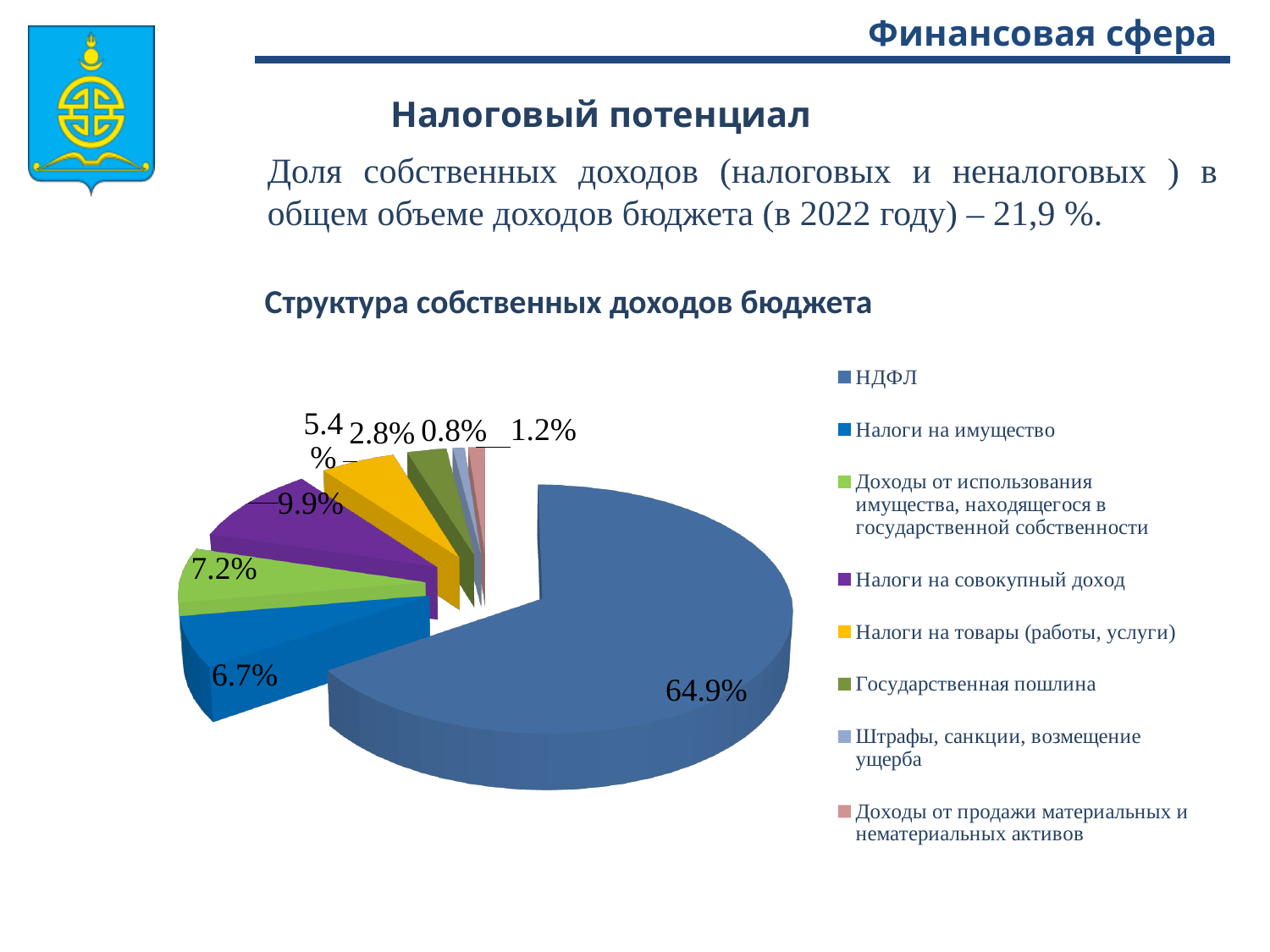
How many categories does the legend list? 8 Which category has the largest slice of the pie? НДФЛ What colour is the slice for Налоги на товары (работы, услуги)? yellow What is the value shown for Налоги на имущество? 6.7% What is the value shown for Налоги на совокупный доход? 9.9% What is the difference between the shares of Доходы от использования имущества, находящегося в государственной собственности and Налоги на имущество? 0.5% What is the value shown for Государственная пошлина? 2.8% What share of the pie does НДФЛ account for? 64.9% What is the value shown for Штрафы, санкции, возмещение ущерба? 0.8% What kind of chart is shown under the heading "Структура собственных доходов бюджета"? pie chart Which is larger: Налоги на совокупный доход or Налоги на товары (работы, услуги)? Налоги на совокупный доход Which category has the smallest slice of the pie? Штрафы, санкции, возмещение ущерба